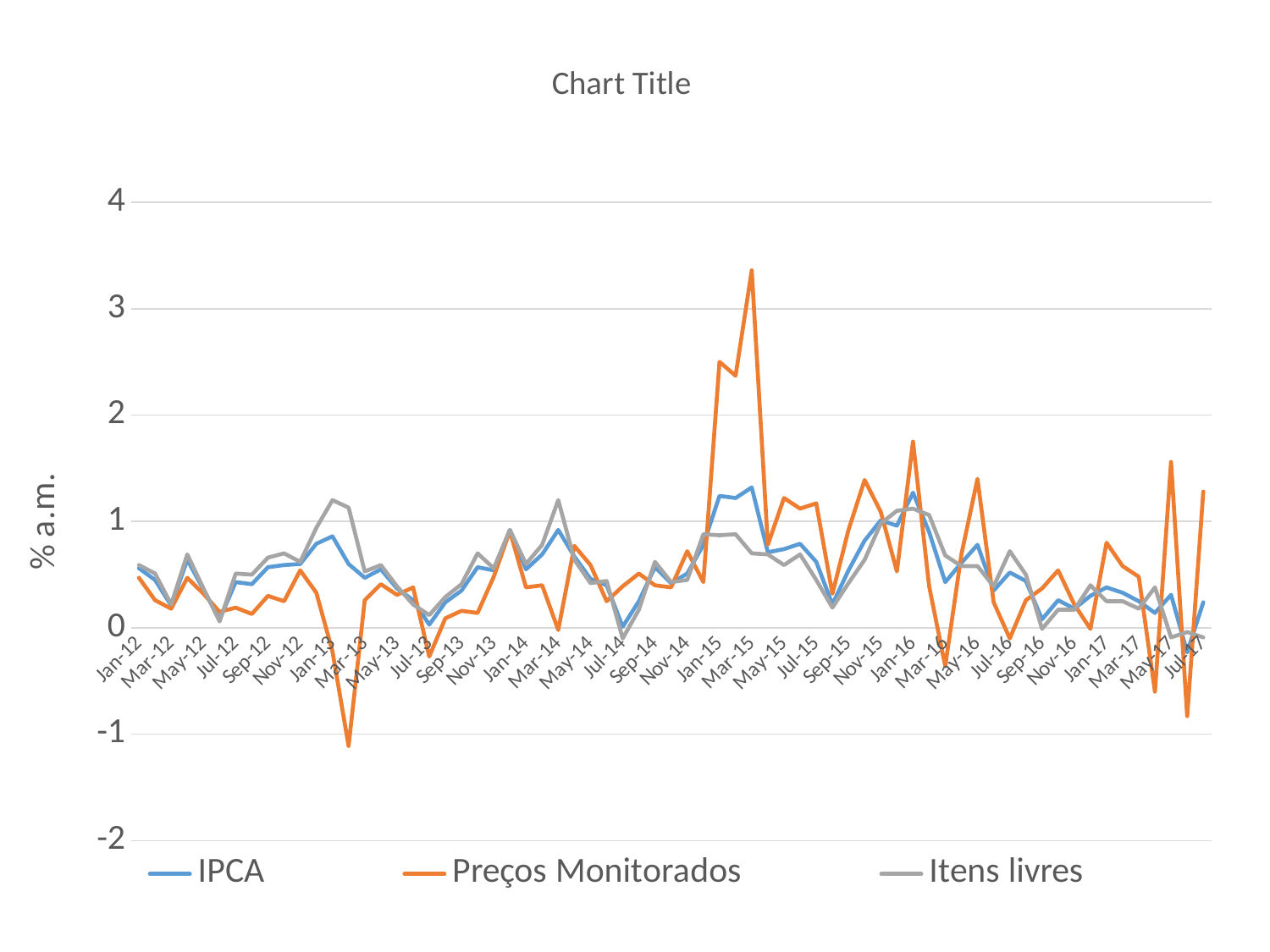
Which series reaches the highest value anywhere on the chart? Preços Monitorados What kind of chart is shown on the slide? line chart Which series is drawn in orange? Preços Monitorados Is the value for Itens livres in Jan-13 greater or less than 1? greater Is the value for Preços Monitorados in Mar-13 greater or less than 0? greater How many series does the legend list? 3 In Jan-13, which is larger, Itens livres or Preços Monitorados? Itens livres Is the value for Preços Monitorados in Mar-15 greater or less than 3? greater Which series reaches the lowest value anywhere on the chart? Preços Monitorados What is the title shown above the chart? Chart Title In Mar-15, which is larger, IPCA or Preços Monitorados? Preços Monitorados